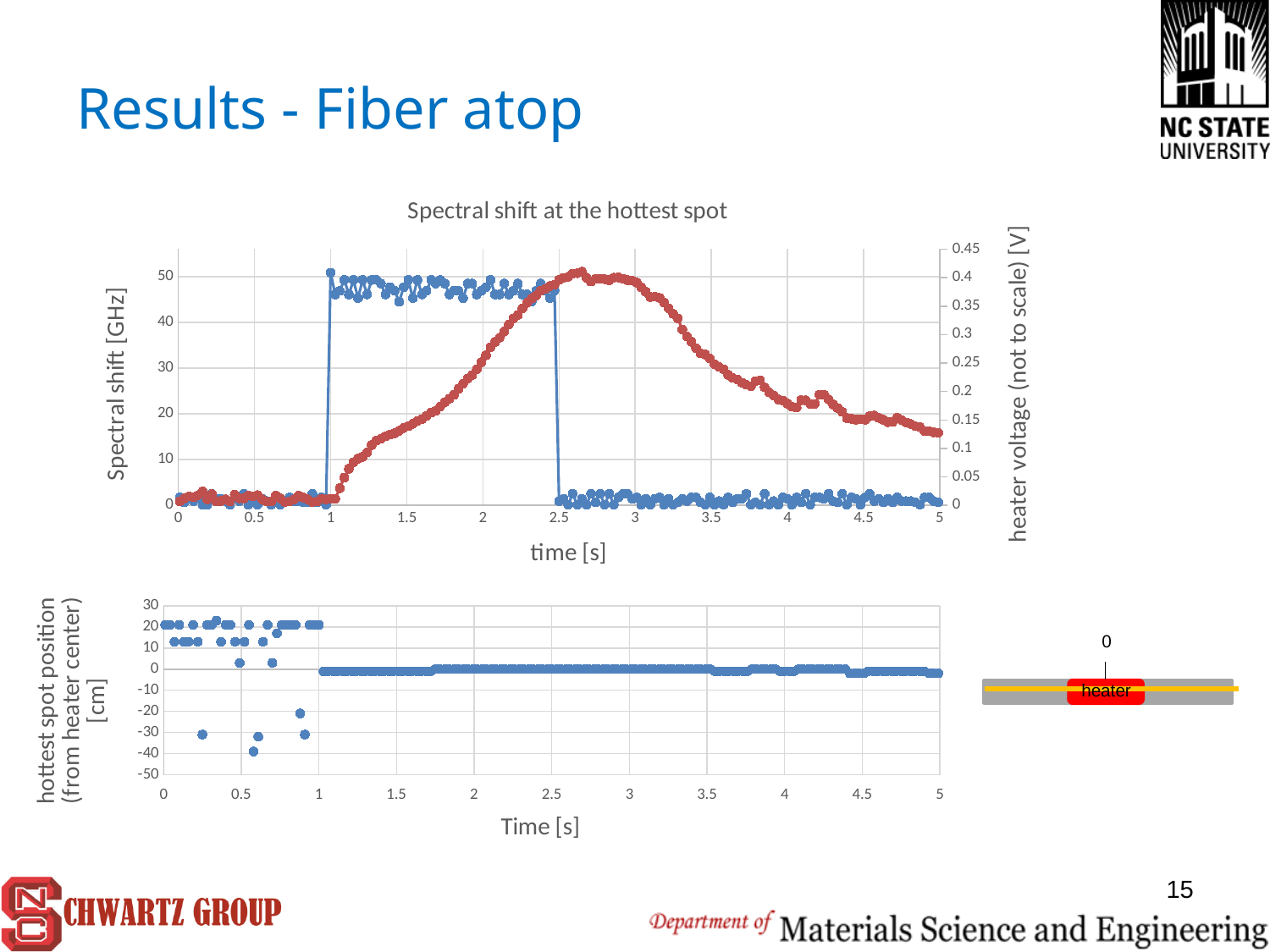
What is the highest tick value shown on the right vertical axis of the top chart? 0.45 In the top chart, is the spectral shift (blue series) at time 2 s greater or less than 40 GHz? greater In the top chart, does the heater voltage (red series) rise or fall between time 3 s and 5 s? fall In the top chart, is the spectral shift (blue series) at time 4 s greater or less than 10 GHz? less What kind of chart is the top chart, 'Spectral shift at the hottest spot'? scatter chart In the bottom chart, is the hottest spot position at time 3 s greater or less than 10 cm? less What is the title of the top chart? Spectral shift at the hottest spot In the top chart, what is the label of the left vertical axis? Spectral shift [GHz] In the top chart, does the heater voltage (red series) rise or fall between time 1 s and 2.5 s? rise What kind of chart is the bottom chart showing hottest spot position? scatter chart